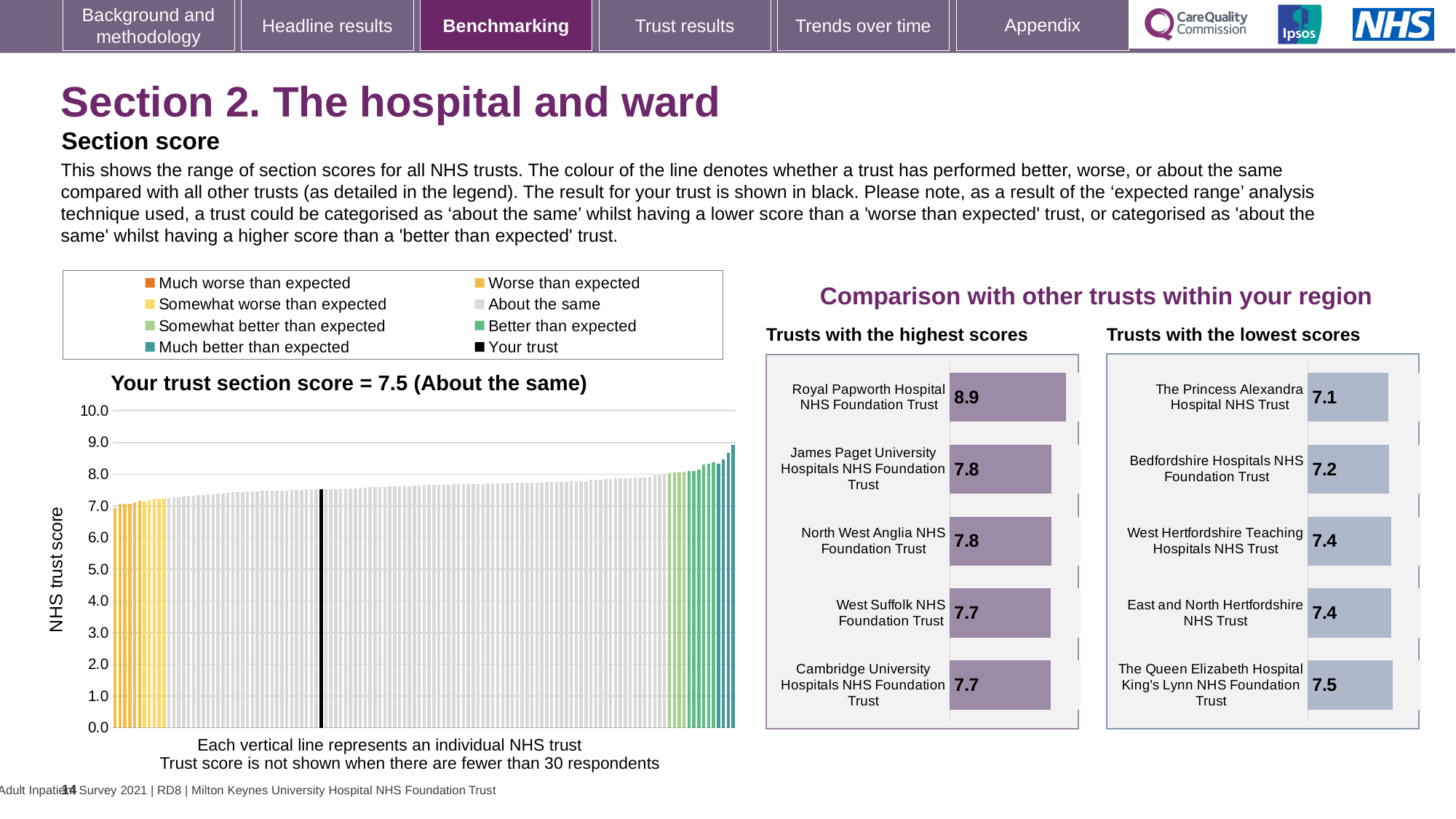
In the 'Trusts with the highest scores' chart, which trust has the highest score? Royal Papworth Hospital NHS Foundation Trust In the 'Trusts with the highest scores' chart, what is the score for West Suffolk NHS Foundation Trust? 7.7 In the 'Trusts with the lowest scores' chart, what is the difference between the scores of The Queen Elizabeth Hospital King's Lynn NHS Foundation Trust and The Princess Alexandra Hospital NHS Trust? 0.4 In the 'Trusts with the lowest scores' chart, what is the score for Bedfordshire Hospitals NHS Foundation Trust? 7.2 What kind of chart is the chart on the left showing the range of section scores for all NHS trusts? bar chart In the 'Trusts with the lowest scores' chart, which has the larger score: West Hertfordshire Teaching Hospitals NHS Trust or Bedfordshire Hospitals NHS Foundation Trust? West Hertfordshire Teaching Hospitals NHS Trust In the chart on the left showing the range of section scores, what is the section score for your trust? 7.5 In the 'Trusts with the lowest scores' chart, which trust has the lowest score? The Princess Alexandra Hospital NHS Trust How many trusts are shown in the 'Trusts with the highest scores' chart? 5 In the 'Trusts with the highest scores' chart, what is the score for Royal Papworth Hospital NHS Foundation Trust? 8.9 How many entries does the legend above the chart on the left list? 8 In the 'Trusts with the highest scores' chart, what is the difference between the scores of Royal Papworth Hospital NHS Foundation Trust and Cambridge University Hospitals NHS Foundation Trust? 1.2